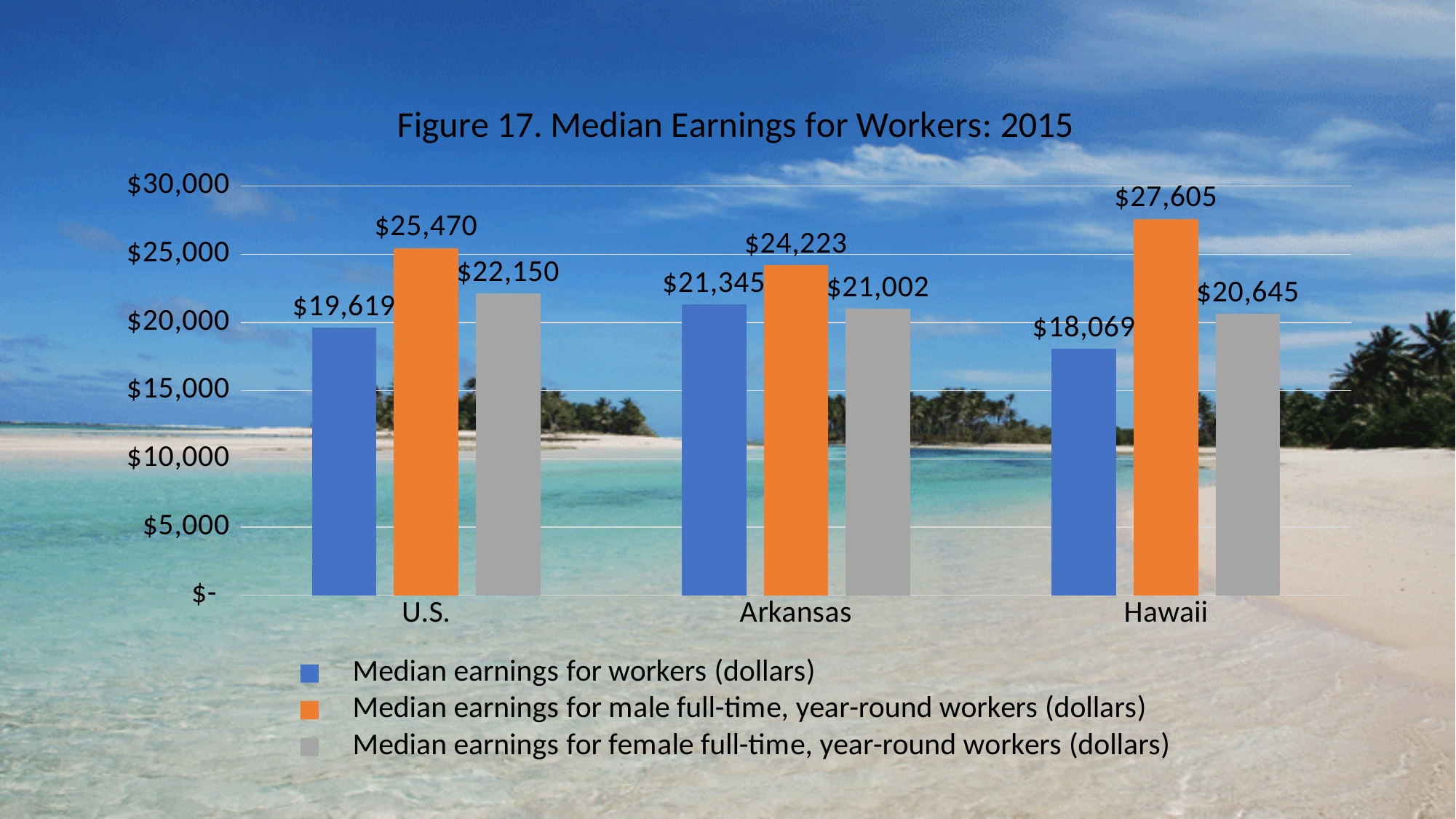
Is the median earnings for female full-time, year-round workers in the U.S. greater or less than $20,000? greater What is the median earnings for female full-time, year-round workers in Arkansas? $21,002 How many categories are shown on the x axis? 3 Which category has the highest median earnings for male full-time, year-round workers? Hawaii What is the title of the chart? Figure 17. Median Earnings for Workers: 2015 What is the median earnings for male full-time, year-round workers in Hawaii? $27,605 Which is larger: median earnings for workers in Arkansas or in the U.S.? Arkansas Which category has the lowest median earnings for workers? Hawaii What is the median earnings for workers in the U.S.? $19,619 How many series does the legend list? 3 What kind of chart is shown on the slide? Bar chart What is the difference between median earnings for male and female full-time, year-round workers in Hawaii? $6,960